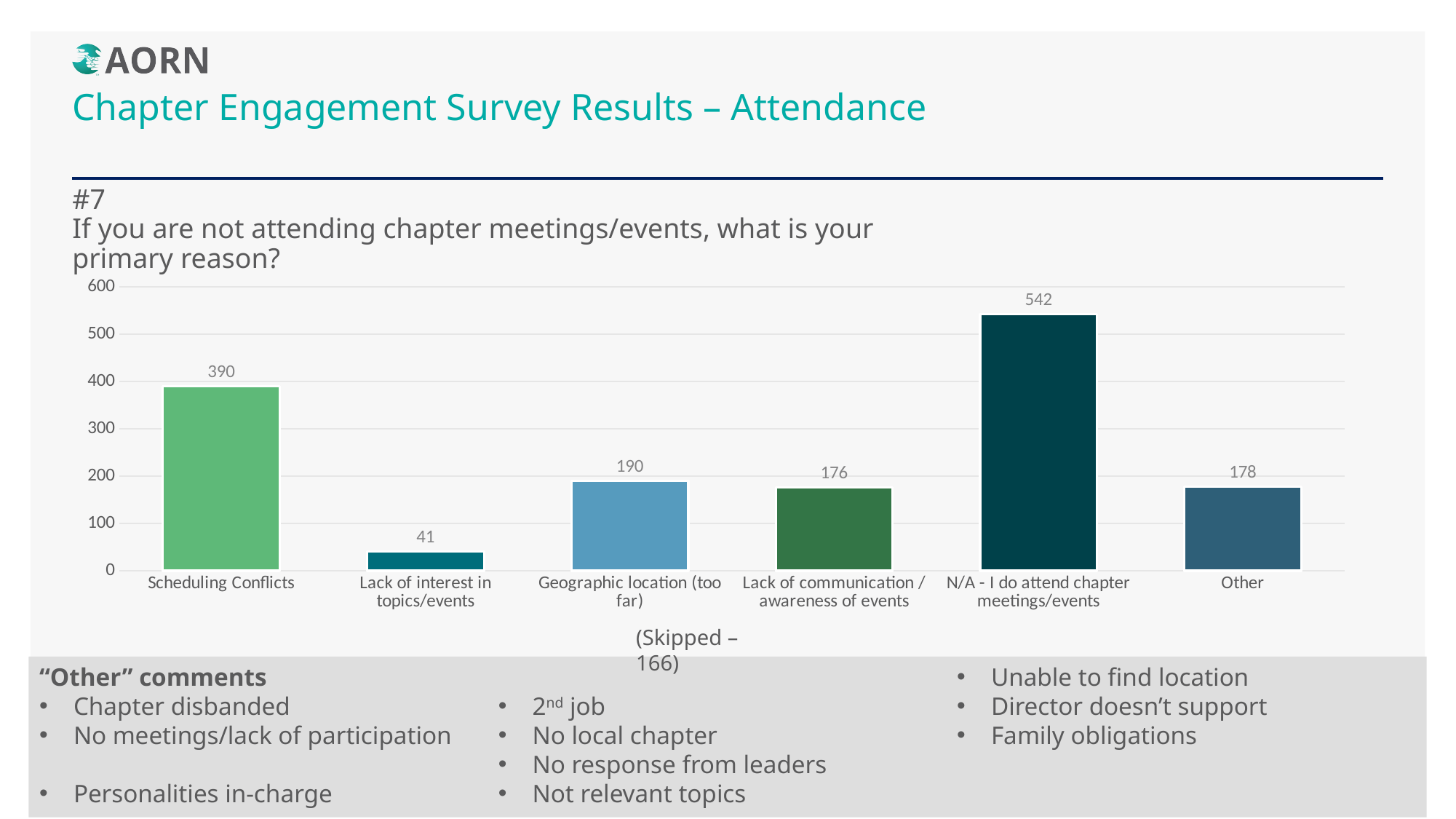
What is the value for Geographic location (too far)? 190 What is the value for Lack of communication / awareness of events? 176 Which category has the lowest value? Lack of interest in topics/events Which is larger, the value for Geographic location (too far) or the value for Other? Geographic location (too far) What kind of chart is shown on the slide? Bar chart What is the value for Lack of interest in topics/events? 41 What is the difference between the values for N/A - I do attend chapter meetings/events and Scheduling Conflicts? 152 What is the value for Scheduling Conflicts? 390 Which category has the highest value? N/A - I do attend chapter meetings/events How many respondents skipped the question, according to the note below the chart? 166 How many categories are shown in the chart? 6 What is the value for Other? 178